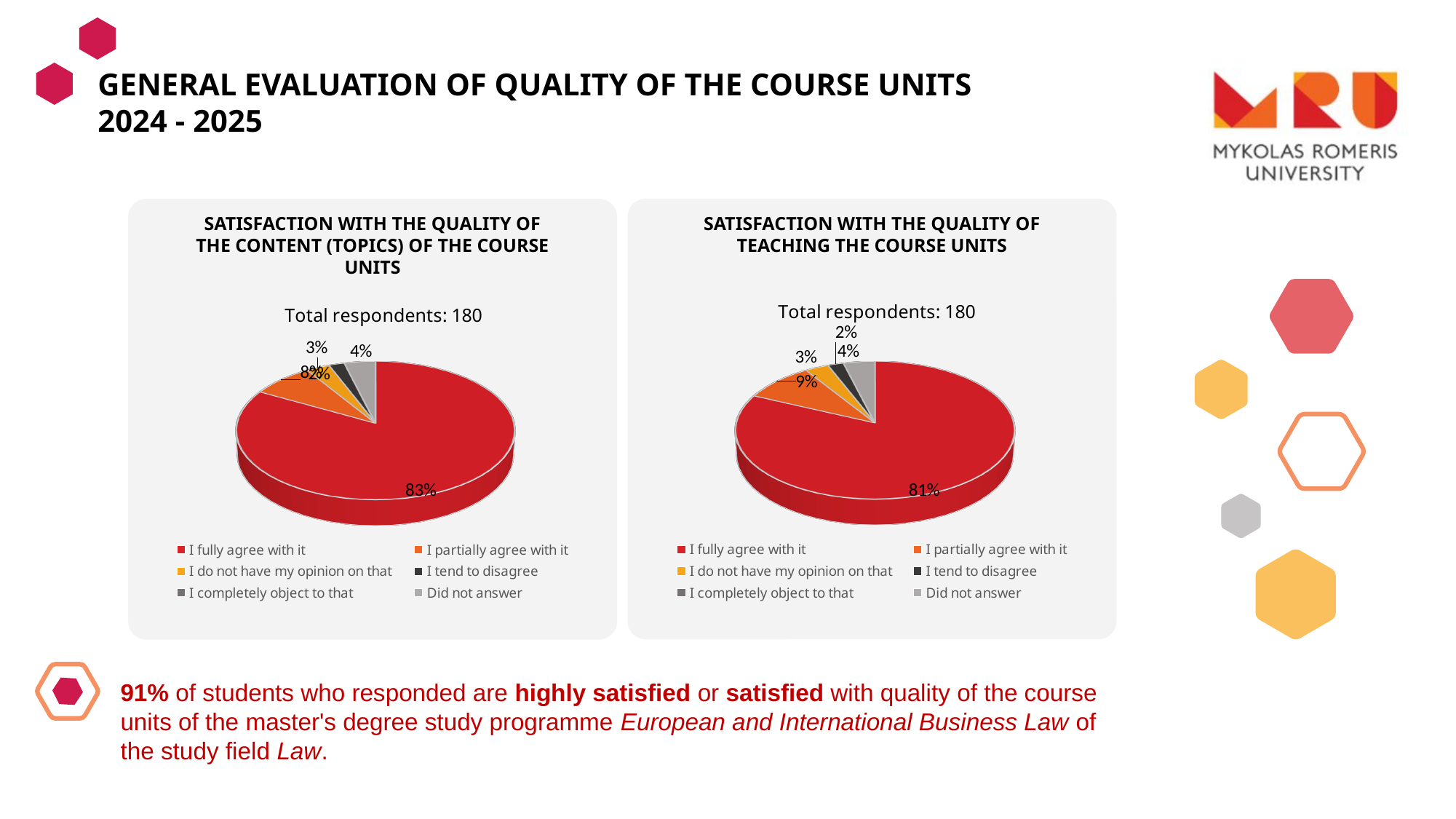
In the chart titled 'Satisfaction with the quality of teaching the course units', what share of respondents 'Did not answer'? 4% In the chart titled 'Satisfaction with the quality of the content (topics) of the course units', which response category has the largest slice? I fully agree with it In the chart titled 'Satisfaction with the quality of teaching the course units', what share of respondents chose 'I partially agree with it'? 9% What type of chart is used in the 'Satisfaction with the quality of teaching the course units' panel? Pie chart How many response categories does the legend of the 'Satisfaction with the quality of the content (topics) of the course units' chart list? 6 Which chart has the larger share for 'I fully agree with it': the content (topics) chart or the teaching chart? The content (topics) chart In the chart titled 'Satisfaction with the quality of teaching the course units', what share of respondents chose 'I fully agree with it'? 81% In the chart titled 'Satisfaction with the quality of teaching the course units', which response category has the largest slice? I fully agree with it In the chart titled 'Satisfaction with the quality of the content (topics) of the course units', what share of respondents chose 'I fully agree with it'? 83% In the chart titled 'Satisfaction with the quality of the content (topics) of the course units', what share of respondents 'Did not answer'? 4% What is the difference in percentage points between the 'I fully agree with it' share in the content (topics) chart (83%) and in the teaching chart (81%)? 2 percentage points How many total respondents are reported for the 'Satisfaction with the quality of teaching the course units' chart? 180